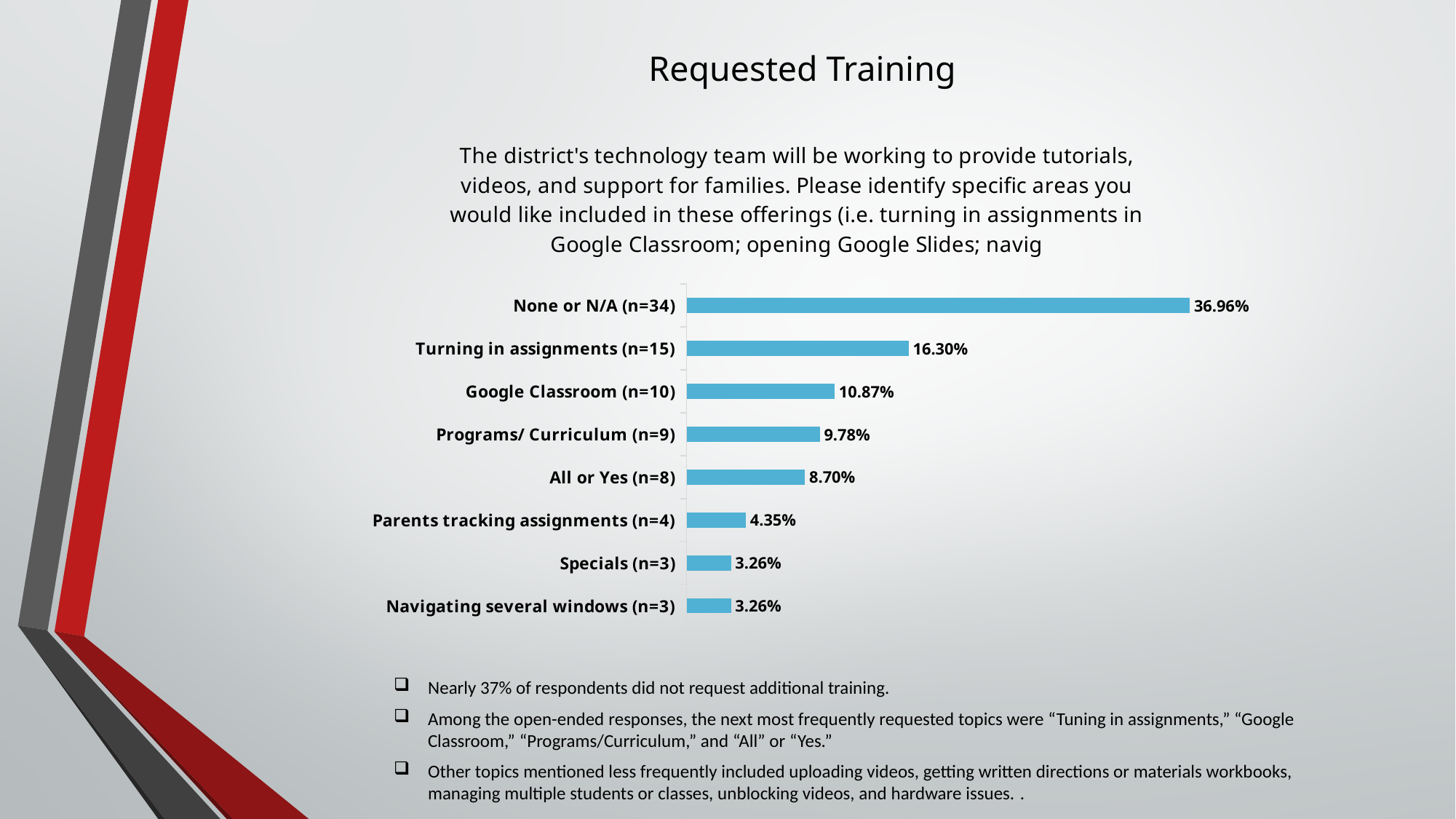
What percentage is shown for "Parents tracking assignments (n=4)"? 4.35% How many categories are plotted in the chart? 8 What colour are the bars in the chart? Blue What is the difference in percentage points between "None or N/A (n=34)" and "Turning in assignments (n=15)"? 20.66 What percentage is shown for "None or N/A (n=34)"? 36.96% Which category has the highest percentage? None or N/A (n=34) Which two categories share the same value of 3.26%? Specials (n=3) and Navigating several windows (n=3) What is the title of the slide containing the chart? Requested Training What is the difference in percentage points between "Google Classroom (n=10)" and "Programs/ Curriculum (n=9)"? 1.09 What is the value for "Turning in assignments (n=15)"? 16.30% What kind of chart is shown on the slide? Bar chart Which is larger: the value for "All or Yes (n=8)" or the value for "Specials (n=3)"? All or Yes (n=8)